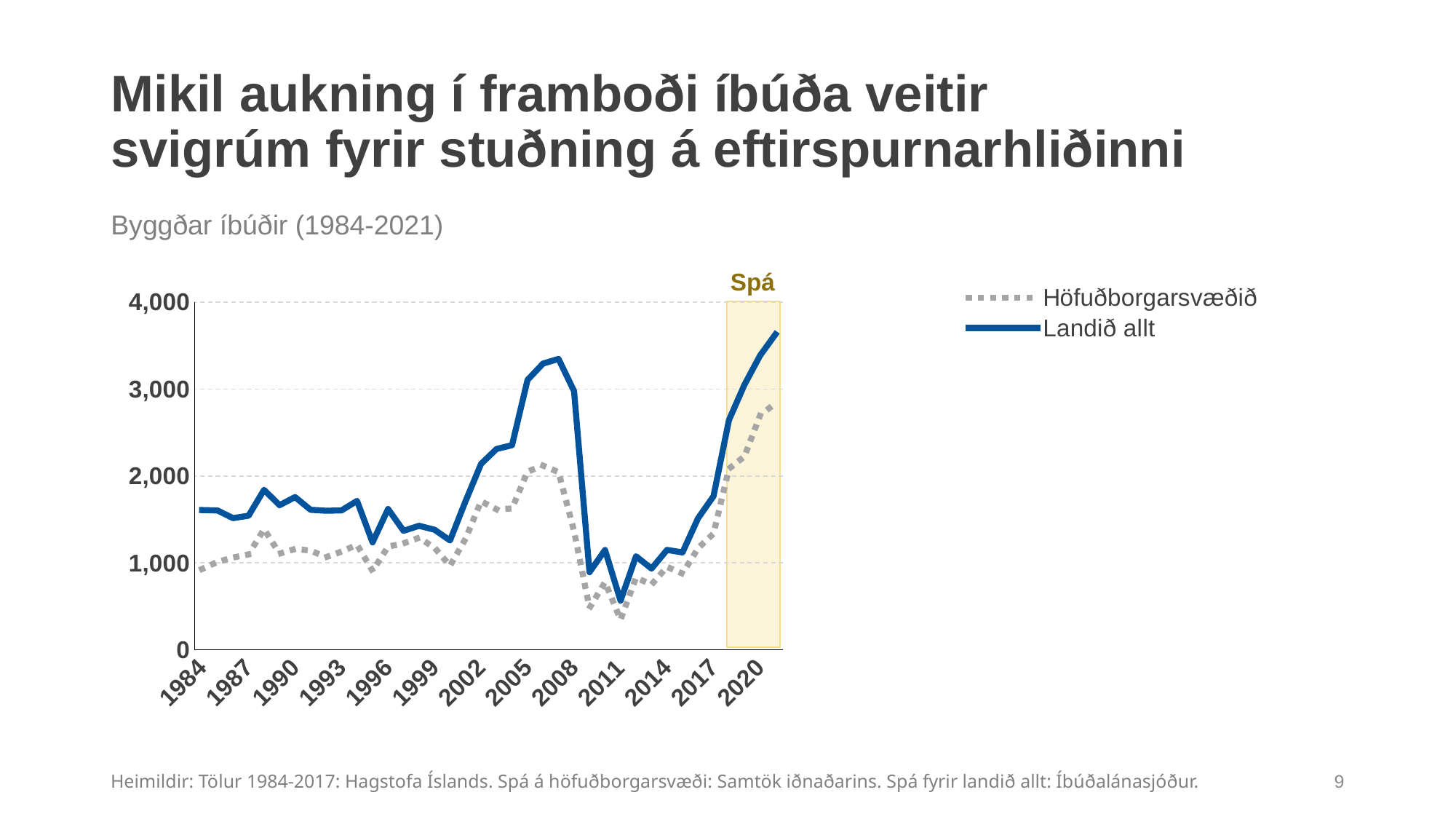
What label is written above the shaded area at the right end of the chart? Spá How many series does the legend list? 2 What kind of chart is shown on the slide? line chart Is the value for Höfuðborgarsvæðið in 2021 greater or less than 3,000? less Which series is drawn with a dotted grey line? Höfuðborgarsvæðið Is the value for Höfuðborgarsvæðið in 1984 greater or less than 1,000? less Is the value for Landið allt in 2011 greater or less than 1,000? less Does the Landið allt series rise or fall between 2011 and 2021? rise Which series has the higher value in 2007, Landið allt or Höfuðborgarsvæðið? Landið allt Does the Landið allt series rise or fall between 2007 and 2010? fall